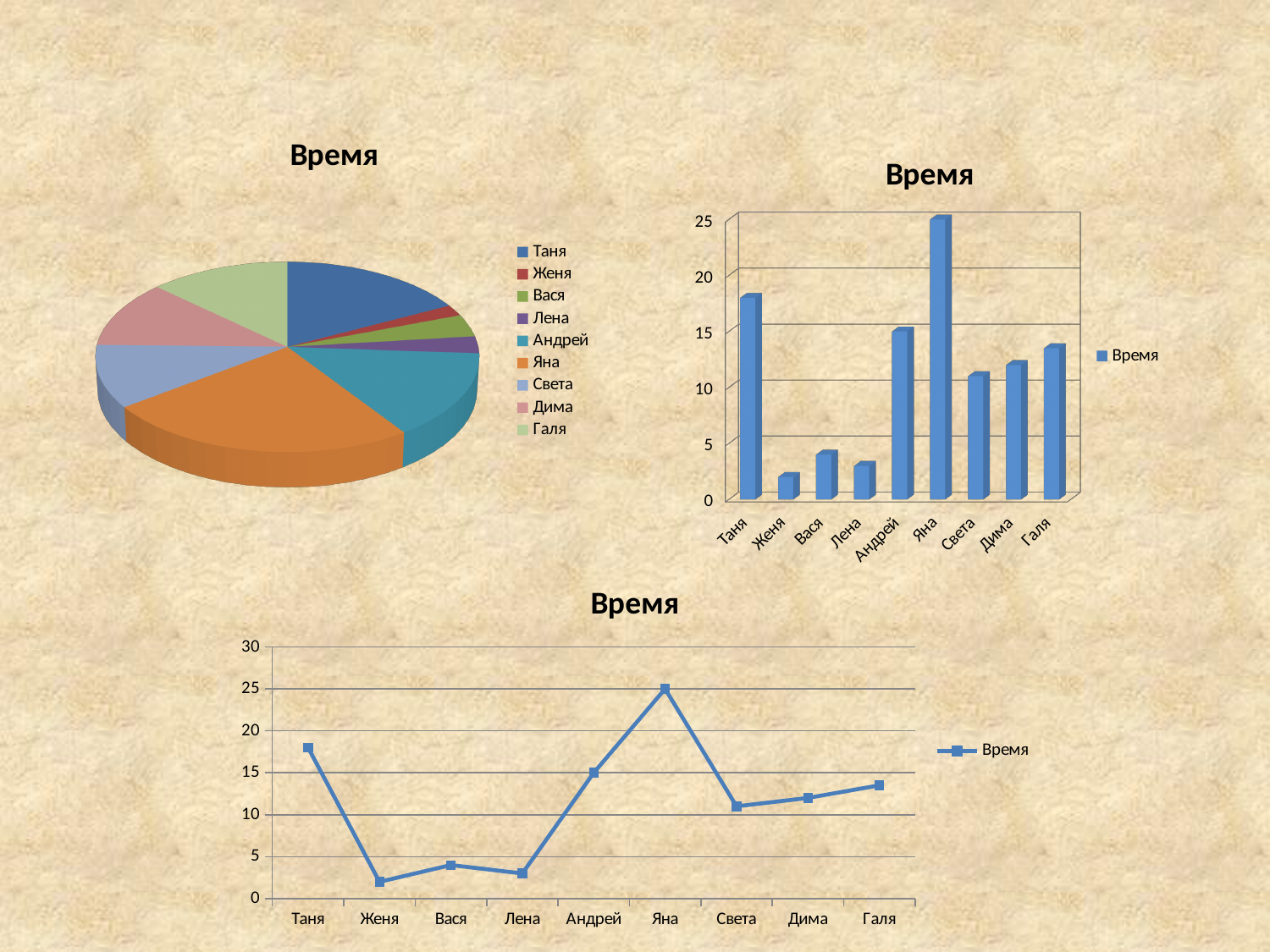
How many categories are shown on the x axis of the bottom line chart? 9 What kind of chart is the top-right chart on the slide? bar chart In the bottom line chart, is the value for Света greater or less than 15? less In the top-right bar chart, which category has the highest value? Яна In the top-right bar chart, which is larger, the value for Таня or the value for Дима? Таня What kind of chart is the top-left chart on the slide? pie chart In the bottom line chart, what is the value for Андрей? 15 What kind of chart is the bottom chart on the slide? line chart In the top-right bar chart, which category has the lowest value? Женя In the bottom line chart, what is the value for Яна? 25 In the top-left pie chart, which slice is the largest? Яна In the top-right bar chart, is the value for Таня greater or less than 15? greater